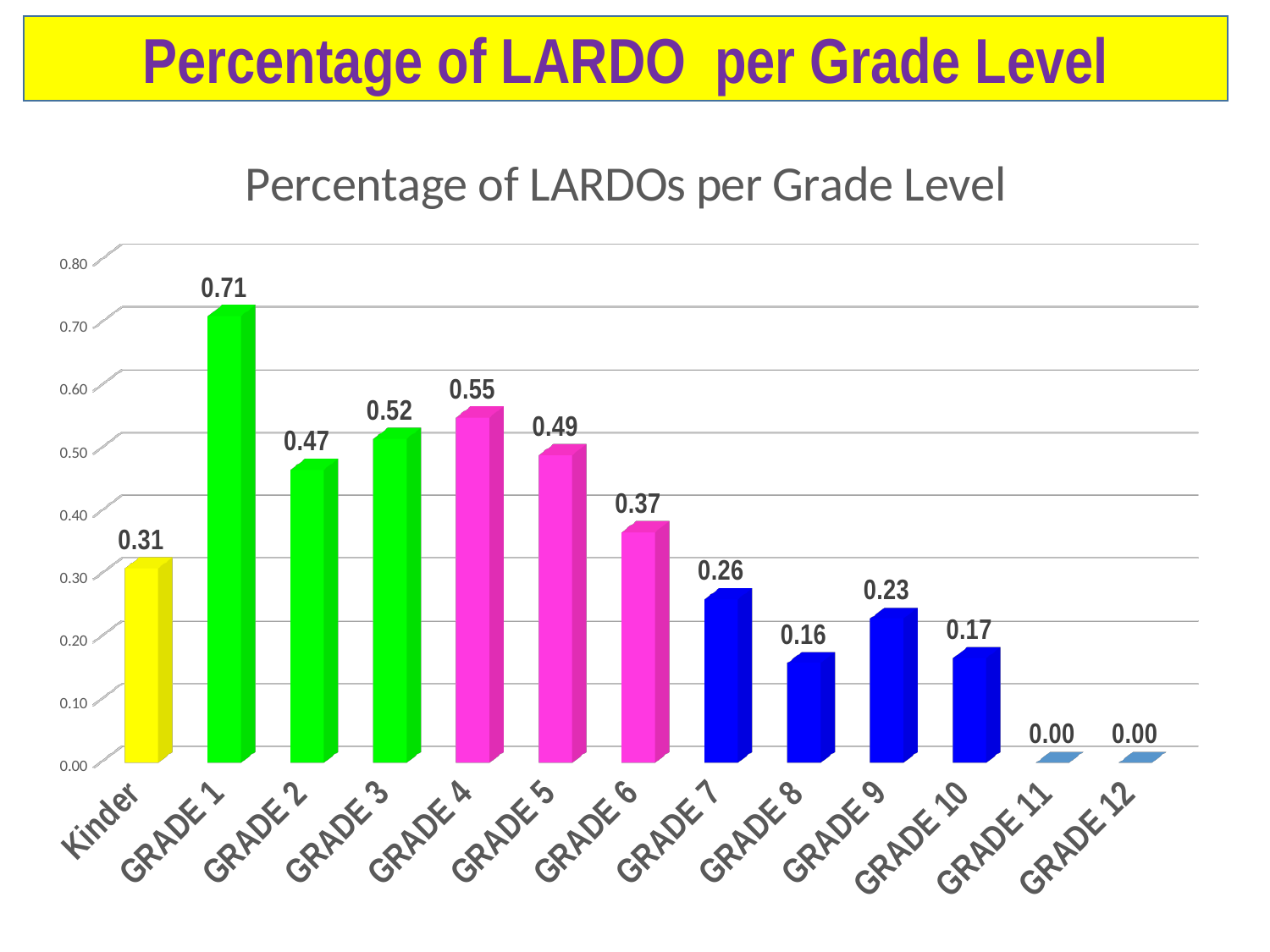
What is the value for GRADE 8? 0.16 What is the title of the chart? Percentage of LARDOs per Grade Level Which grade level has the highest value? GRADE 1 Which is larger, the value for GRADE 9 or the value for GRADE 10? GRADE 9 Is the value for GRADE 3 greater or less than 0.50? greater What is the difference between the values for GRADE 4 and GRADE 6? 0.18 What is the value for GRADE 1? 0.71 What kind of chart is shown on the slide? bar chart How many grade levels are shown on the x axis? 13 What colour is the bar for Kinder? yellow Do the values generally rise or fall from GRADE 1 to GRADE 12? fall What is the value for Kinder? 0.31